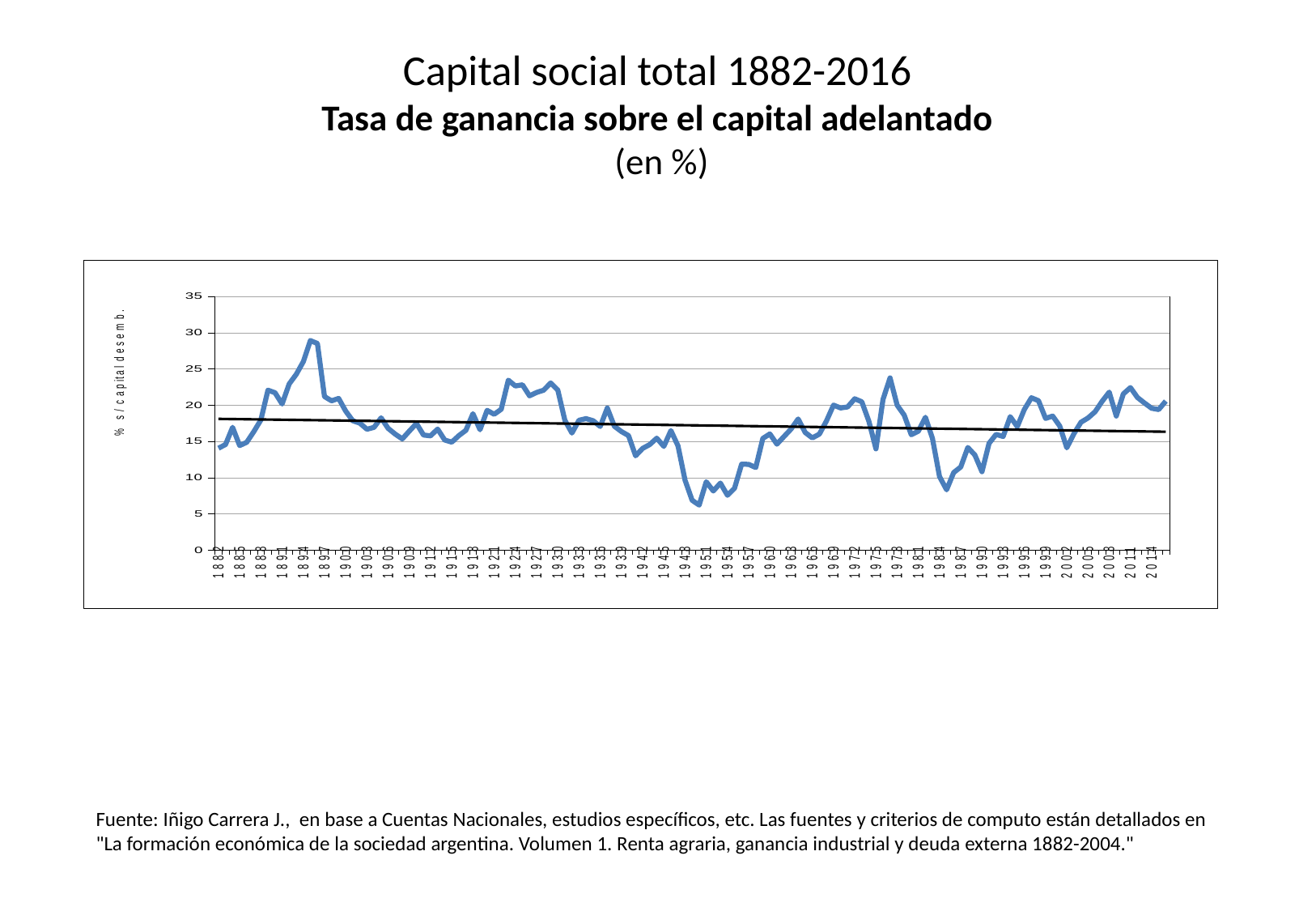
Is the value for 1882 greater or less than 20? less What is the title of the chart on the slide? Capital social total 1882-2016 Tasa de ganancia sobre el capital adelantado (en %) Is the value for 1924 greater or less than 20? greater What is the label on the vertical axis of the chart? % s/capital desemb. Which is larger, the value for 1894 or the value for 1951? 1894 Does the straight black trend line rise or fall from left to right across the chart? fall Is the value for 1894 greater or less than 25? greater Which is larger, the value for 1978 or the value for 1984? 1978 What kind of chart is shown on the slide? line chart